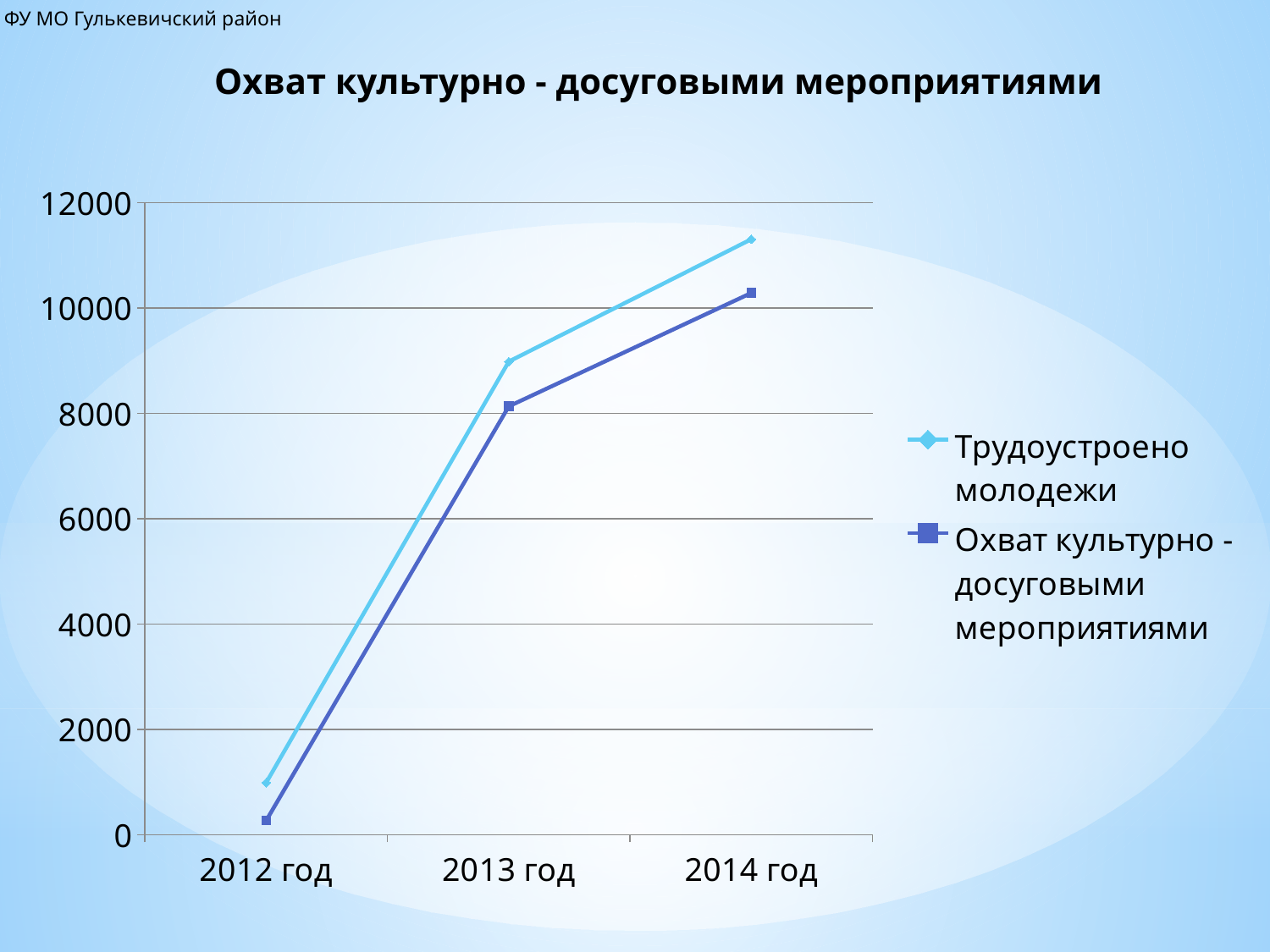
How many series does the legend list? 2 What kind of chart is shown on the slide? line chart Is the value for "Охват культурно - досуговыми мероприятиями" in 2012 год greater or less than 2000? less In which year is the value for "Трудоустроено молодежи" the lowest? 2012 год Do the values for "Трудоустроено молодежи" rise or fall from 2012 год to 2014 год? rise Is the value for "Охват культурно - досуговыми мероприятиями" in 2013 год greater or less than 6000? greater In which year is the value for "Охват культурно - досуговыми мероприятиями" the highest? 2014 год Do the values for "Охват культурно - досуговыми мероприятиями" rise or fall from 2012 год to 2014 год? rise What is the title of the chart? Охват культурно - досуговыми мероприятиями How many years are shown on the x axis? 3